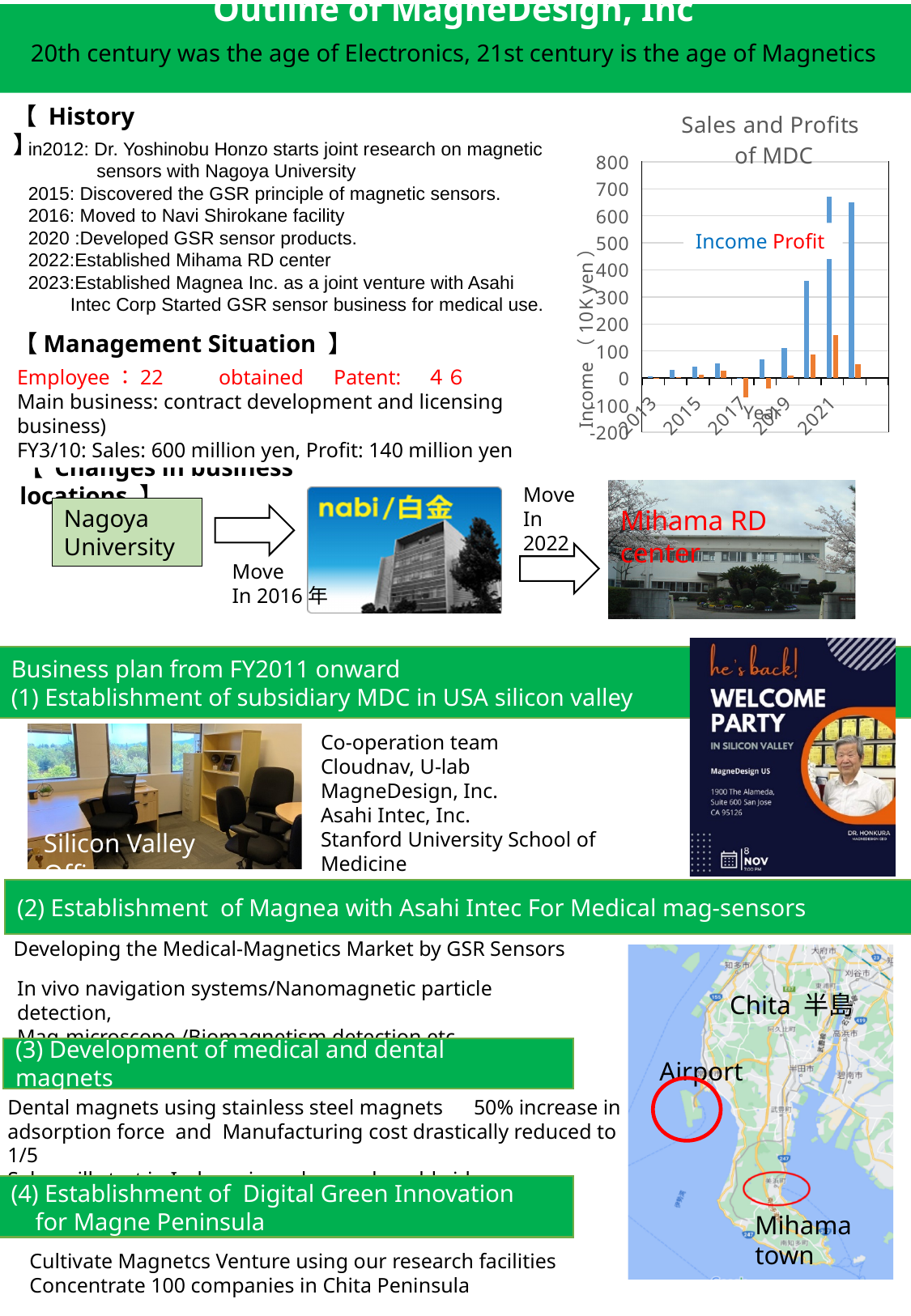
In the "Sales and Profits of MDC" chart, is the Income value at 2021 greater or less than 300? greater In the "Sales and Profits of MDC" chart, does Income generally rise or fall from 2013 to the later years? rise In the "Sales and Profits of MDC" chart, is the Income value at 2015 greater or less than 100? less In the "Sales and Profits of MDC" chart, is the highest Income value greater or less than 600? greater What are the two series shown in the "Sales and Profits of MDC" chart? Income and Profit How many series does the "Sales and Profits of MDC" chart show? 2 What is the title of the chart on the slide? Sales and Profits of MDC In the "Sales and Profits of MDC" chart, which series has the tallest bar, Income or Profit? Income What kind of chart is the "Sales and Profits of MDC" chart? bar chart What is the highest value shown on the y axis of the "Sales and Profits of MDC" chart? 800 In the "Sales and Profits of MDC" chart, which series has a bar that goes below 0? Profit